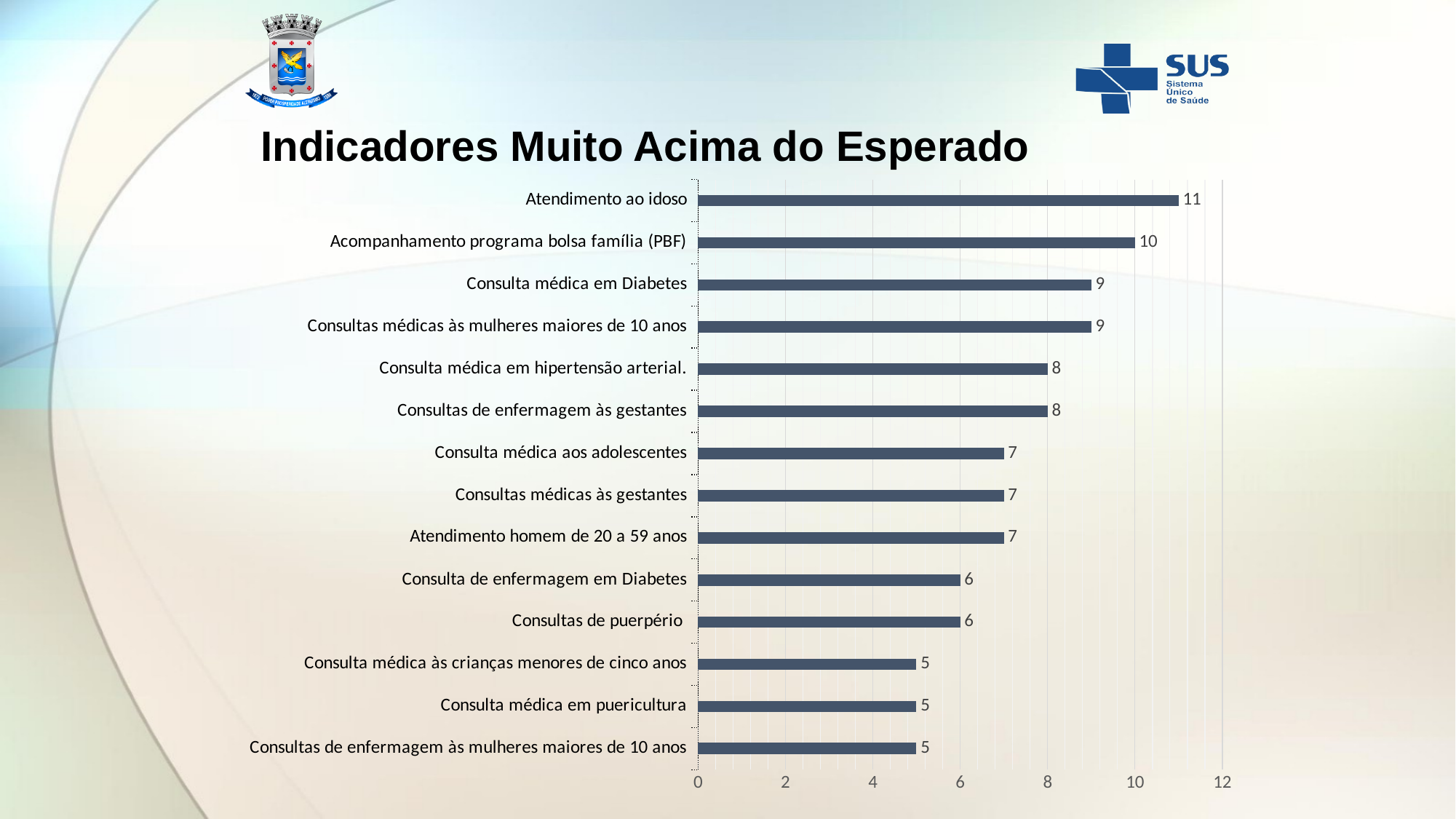
What is the difference between the values for Consulta médica em Diabetes and Consulta de enfermagem em Diabetes? 3 What is the value for Acompanhamento programa bolsa família (PBF)? 10 What kind of chart is shown on the slide? bar chart What is the value for Atendimento ao idoso? 11 What is the value for Consultas de puerpério? 6 Which category has the highest value? Atendimento ao idoso What is the value for Consulta médica aos adolescentes? 7 Which is larger, the value for Consulta médica em hipertensão arterial. or the value for Atendimento homem de 20 a 59 anos? Consulta médica em hipertensão arterial. Is the value for Acompanhamento programa bolsa família (PBF) greater or less than 8? greater What is the title of the chart? Indicadores Muito Acima do Esperado What is the difference between the values for Atendimento ao idoso and Consulta médica em puericultura? 6 How many categories are shown in the chart? 14